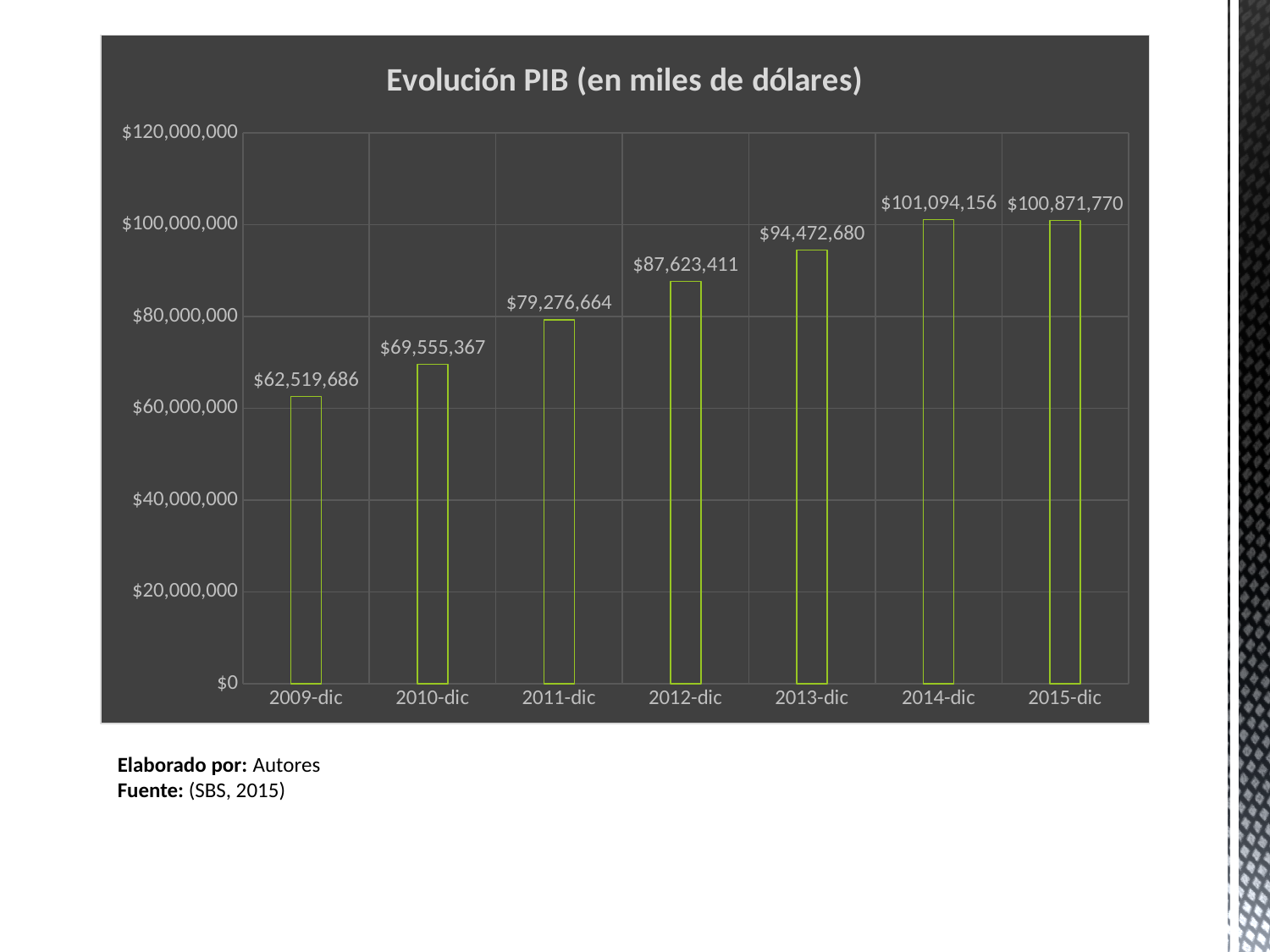
What kind of chart is this? bar chart Which is larger, the value for 2011-dic or the value for 2013-dic? 2013-dic Which year has the highest value? 2014-dic How many years are shown on the x axis? 7 What is the title of the chart? Evolución PIB (en miles de dólares) Is the value for 2012-dic greater or less than $80,000,000? greater What is the value for 2009-dic? $62,519,686 What is the value for 2015-dic? $100,871,770 What is the difference between the values for 2014-dic and 2015-dic? $222,386 What is the difference between the values for 2010-dic and 2009-dic? $7,035,681 What is the value for 2012-dic? $87,623,411 Which year has the lowest value? 2009-dic